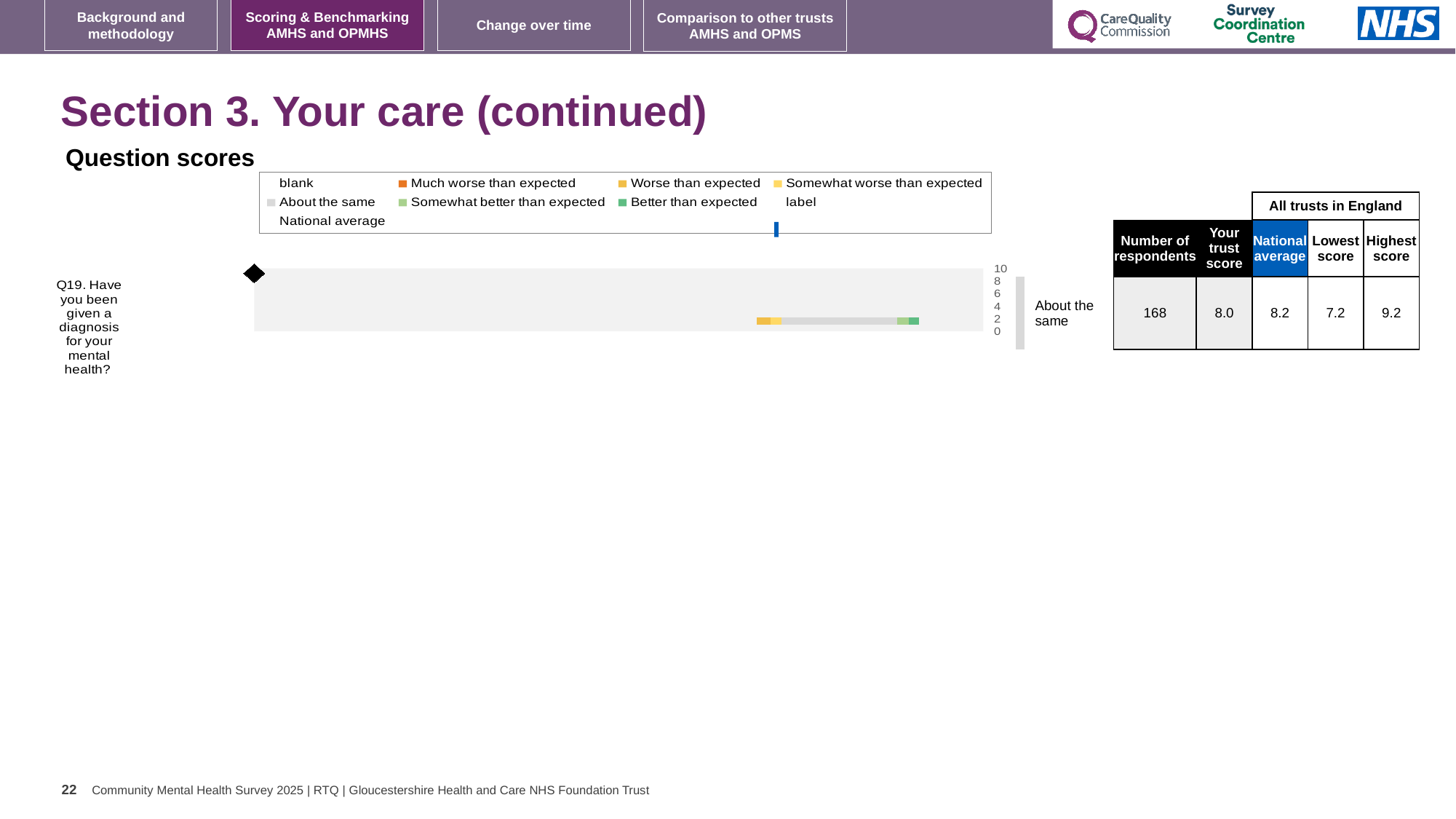
What is the national average for Q19 shown in the table? 8.2 How many respondents answered Q19? 168 Which is larger for Q19, the trust score or the national average? national average What is the lowest score among all trusts in England for Q19? 7.2 What is the maximum value shown on the chart's vertical axis? 10 What is the trust score for Q19 shown in the table? 8.0 What benchmark category is shown next to the bar for Q19? About the same What is the difference between the highest and lowest scores for Q19 across all trusts in England? 2.0 What is the highest score among all trusts in England for Q19? 9.2 Which question is plotted in the 'Question scores' chart? Q19. Have you been given a diagnosis for your mental health? What kind of chart is shown under 'Question scores'? bar chart How many questions are plotted in the 'Question scores' chart? 1